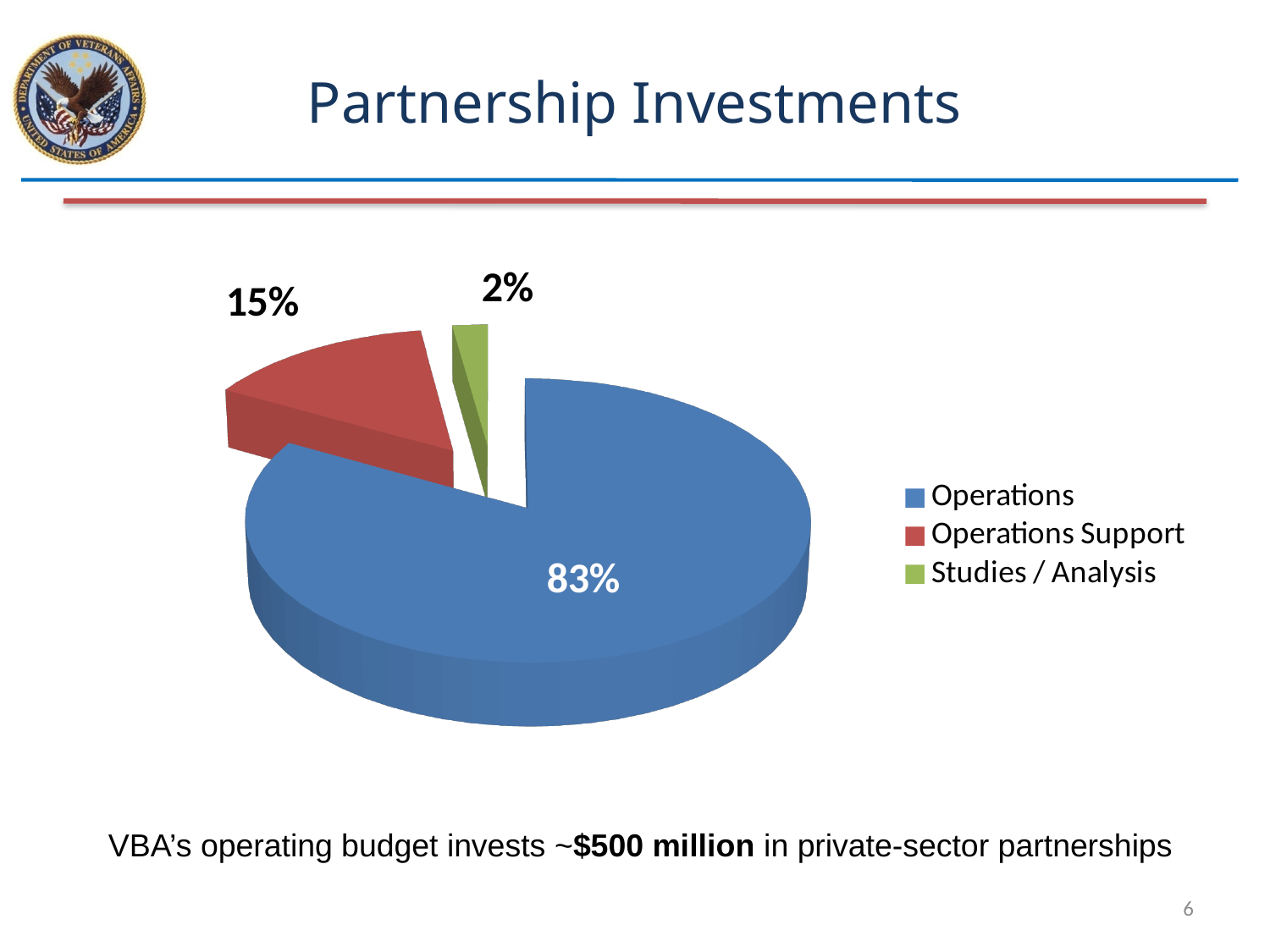
Which category is shown in green in the legend? Studies / Analysis Which category has the smallest slice of the pie? Studies / Analysis What is the difference in percentage points between Operations Support and Studies / Analysis? 13 What colour is the Operations slice? Blue How many categories does the pie chart show? 3 What share of the pie does Operations Support represent? 15% What is the difference in percentage points between Operations and Operations Support? 68 Which category has the largest slice of the pie? Operations What kind of chart is shown on the slide? Pie chart What share of the pie does Operations represent? 83% What share of the pie does Studies / Analysis represent? 2% Which is larger, the Operations Support slice or the Studies / Analysis slice? Operations Support